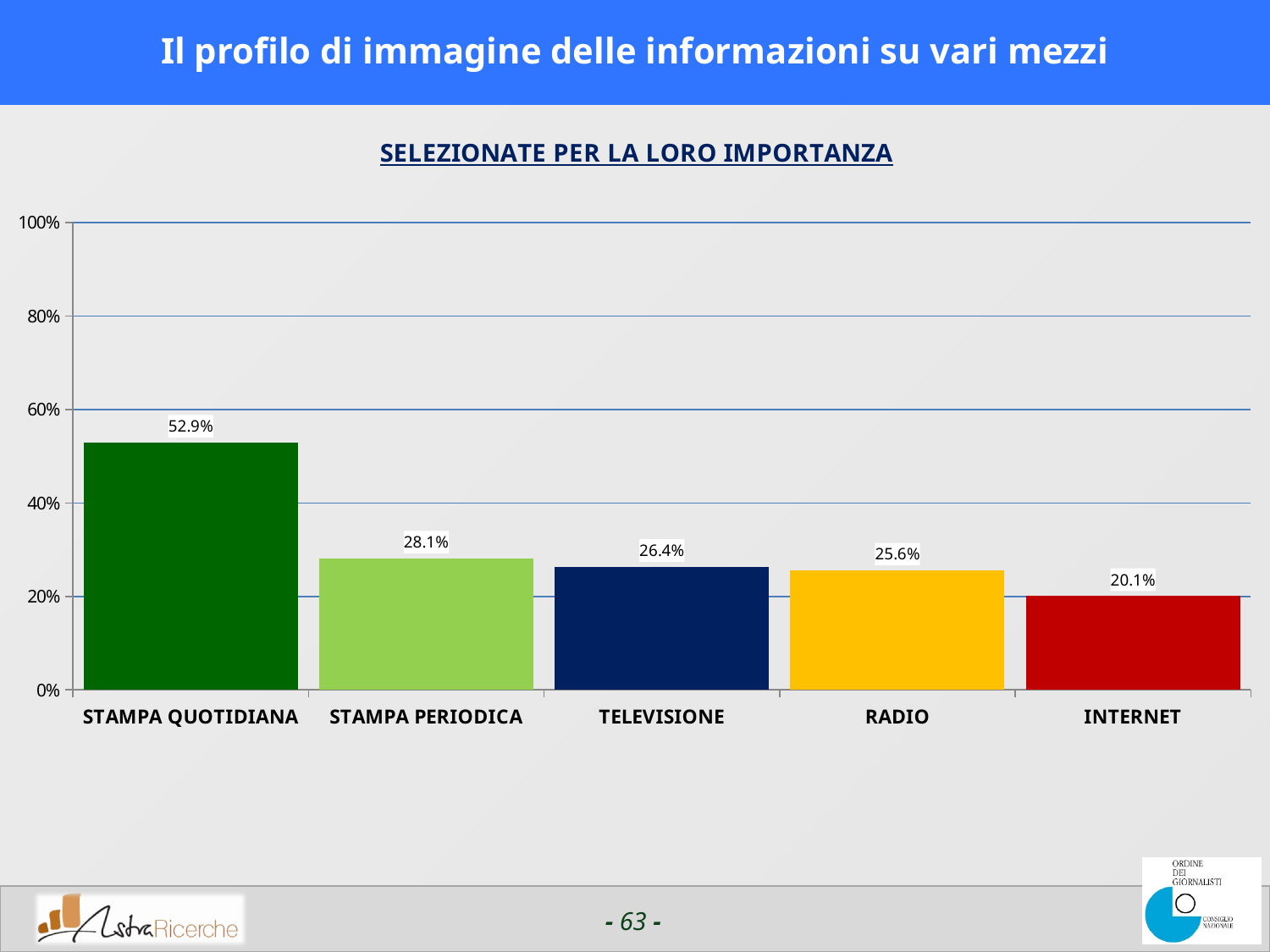
What kind of chart is shown on the slide? bar chart Is the value for STAMPA QUOTIDIANA greater or less than 40%? greater Which category has the highest value? STAMPA QUOTIDIANA What is the value for STAMPA QUOTIDIANA? 52.9% How many categories are shown on the chart? 5 Which is larger, the value for STAMPA PERIODICA or the value for INTERNET? STAMPA PERIODICA What is the value for TELEVISIONE? 26.4% Which category has the lowest value? INTERNET What is the difference between the values for STAMPA QUOTIDIANA and STAMPA PERIODICA? 24.8% What is the value for RADIO? 25.6% What is the value for INTERNET? 20.1% What is the difference between the values for RADIO and INTERNET? 5.5%